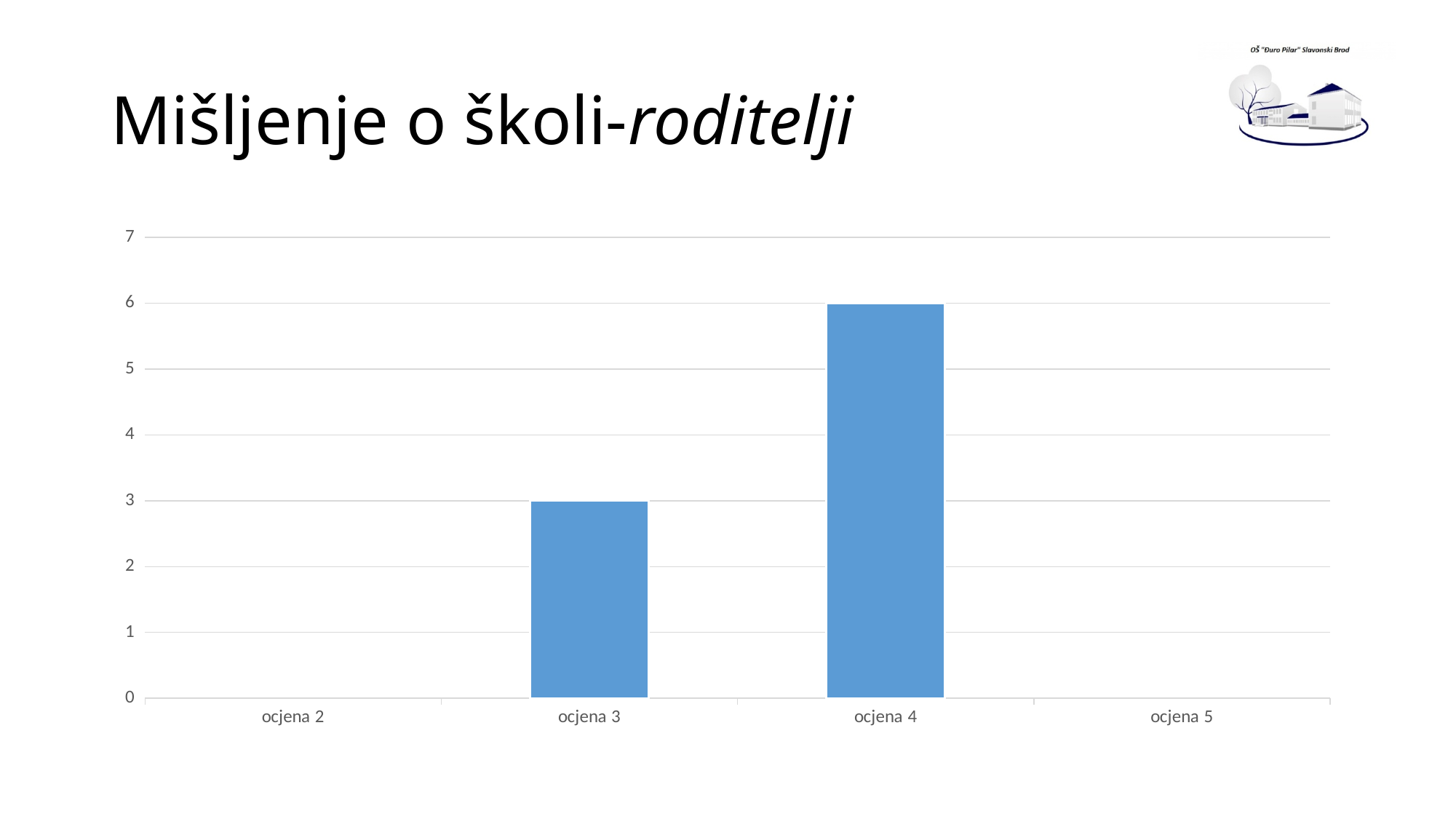
How many categories are shown on the x axis of the chart? 4 How many categories have a visible bar in the chart? 2 Is the value for ocjena 4 greater or less than 5? greater What is the difference between the values for ocjena 4 and ocjena 3? 3 What is the value for ocjena 3? 3 What colour are the bars in the chart? blue What kind of chart is shown on the slide? bar chart Which is larger, the value for ocjena 3 or the value for ocjena 4? ocjena 4 What is the value for ocjena 4? 6 Is the value for ocjena 3 greater or less than 4? less Which categories have no bar shown in the chart? ocjena 2 and ocjena 5 Which category has the highest value? ocjena 4